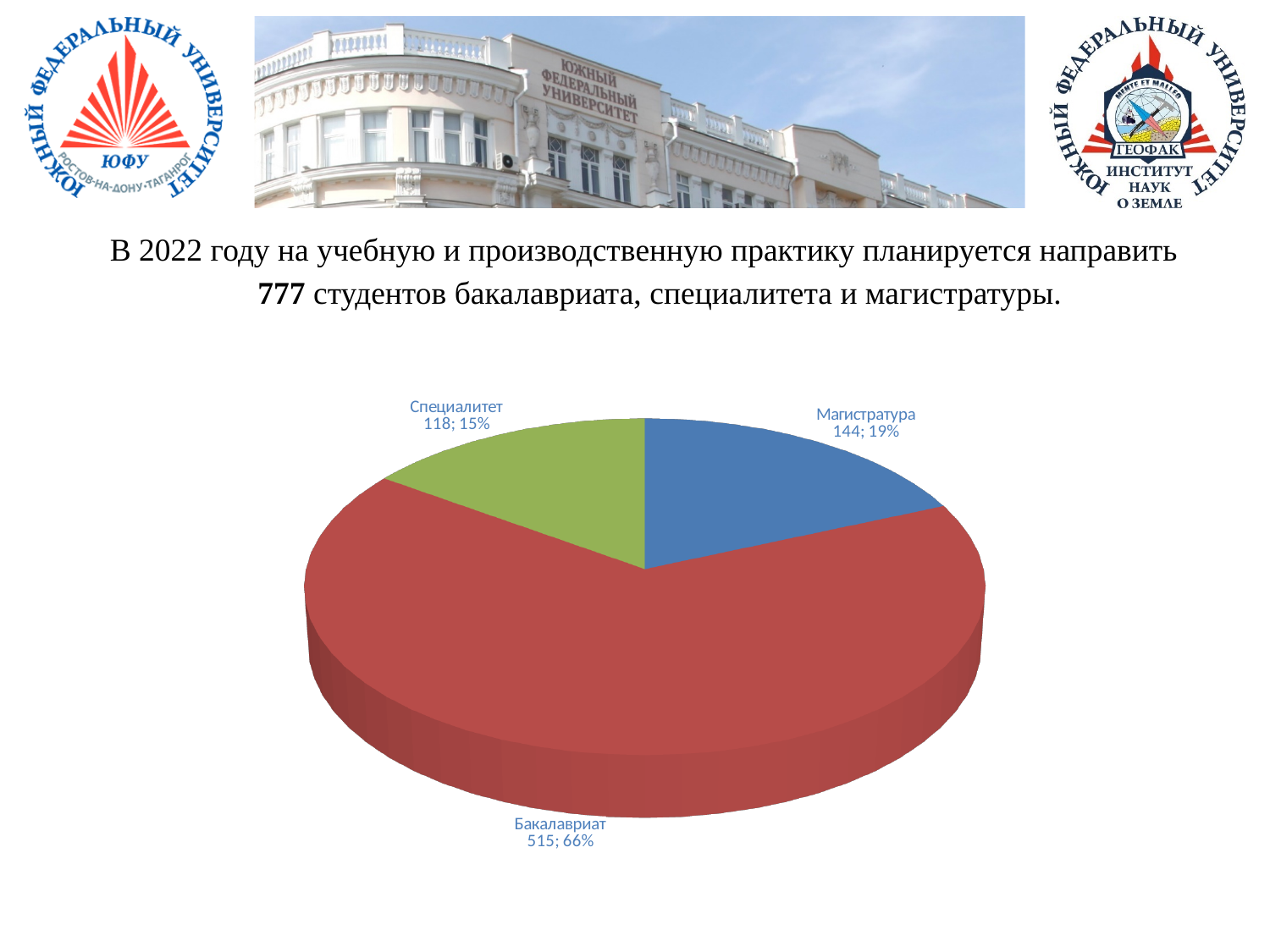
What share of the pie does Бакалавриат represent? 66% How many students are planned for Магистратура according to the pie chart? 144 What share of the pie does Магистратура represent? 19% What is the difference between the number of students for Бакалавриат and Магистратура? 371 What share of the pie does Специалитет represent? 15% What kind of chart is shown on the slide? pie chart How many students are planned for Бакалавриат according to the pie chart? 515 How many students are planned for Специалитет according to the pie chart? 118 How many slices does the pie chart have? 3 Which category has the largest slice of the pie? Бакалавриат Which is larger, the value for Магистратура or the value for Специалитет? Магистратура Which category has the smallest slice of the pie? Специалитет